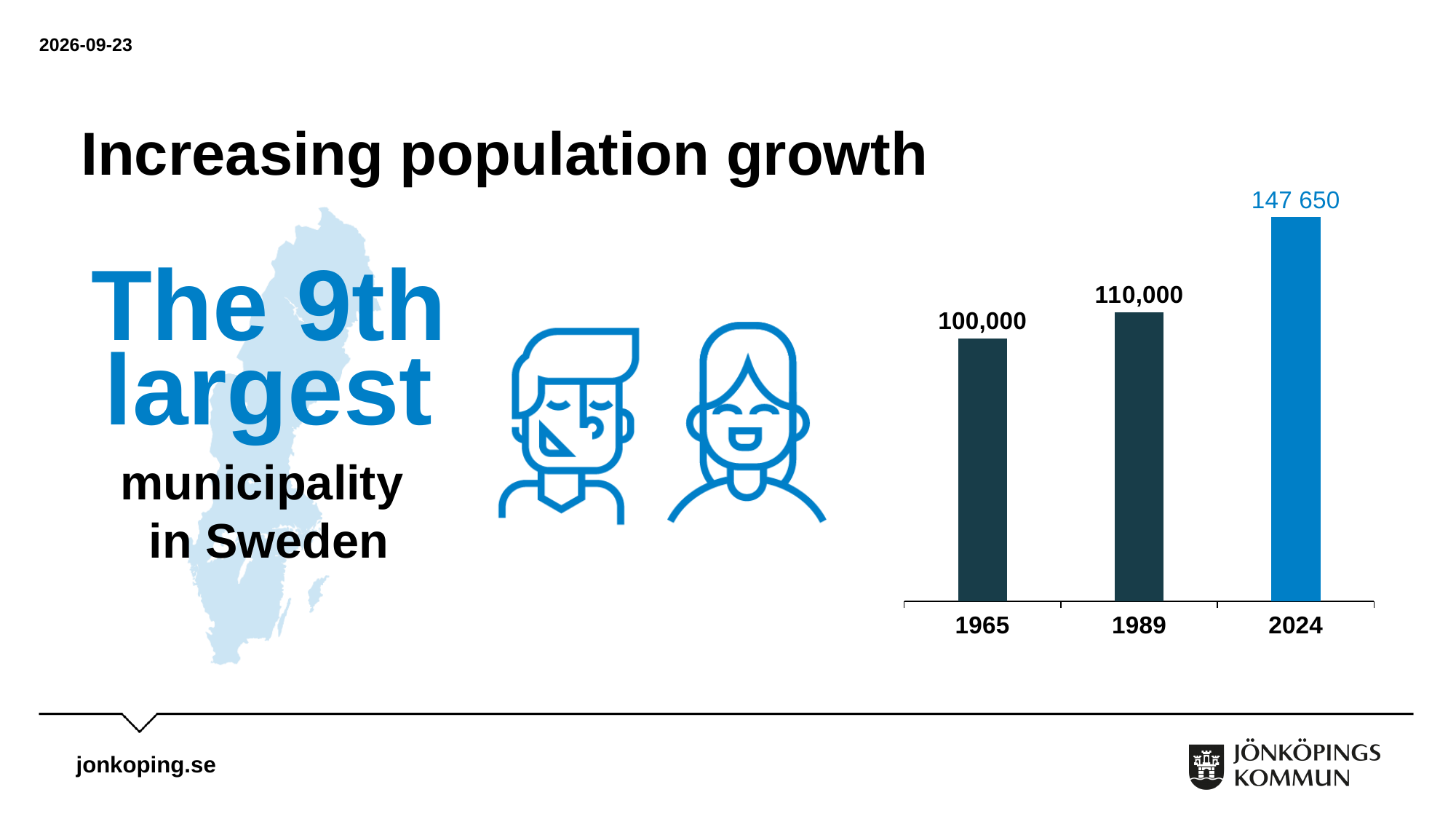
What kind of chart is shown on the slide? Bar chart How many years are shown as bars in the chart? 3 Which year has the lowest bar in the chart? 1965 What is the difference between the values for 2024 and 1989? 37,650 What is the population value shown for 1965? 100,000 What is the difference between the values for 2024 and 1965? 47,650 What is the population value shown for 1989? 110,000 Do the values rise or fall from 1965 to 2024? Rise Which year has the highest bar in the chart? 2024 Which is larger, the value for 1989 or the value for 2024? 2024 What is the population value shown for 2024? 147 650 What is the difference between the values for 1989 and 1965? 10,000